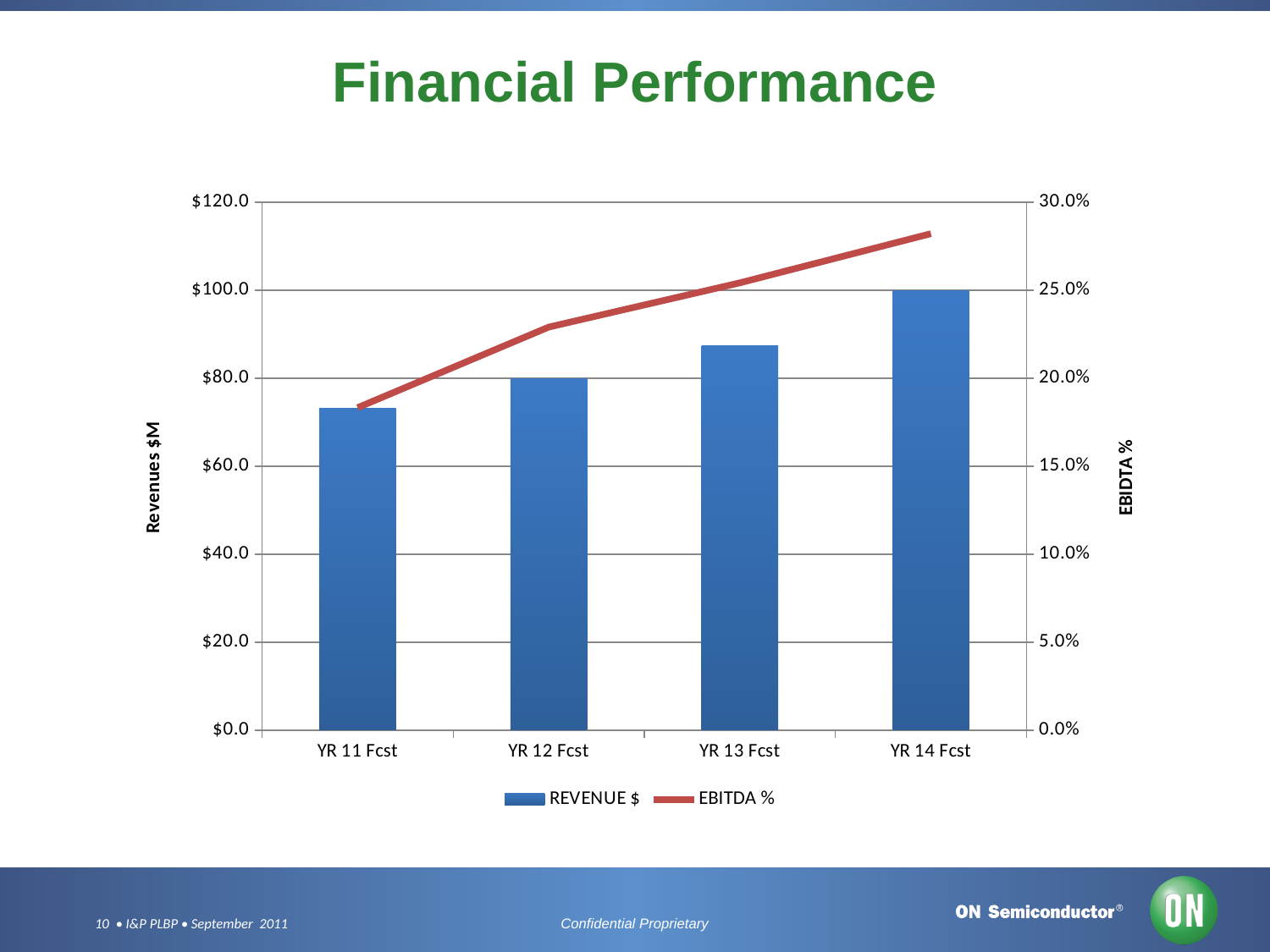
Which category has the highest revenue? YR 14 Fcst What is the difference in revenue between YR 14 Fcst and YR 12 Fcst? $20.0 How many categories are shown on the x axis? 4 Is the revenue for YR 11 Fcst greater or less than $80.0? less Is the EBITDA % for YR 14 Fcst greater or less than 25.0%? greater Does the EBITDA % line rise or fall from YR 11 Fcst to YR 14 Fcst? rise Which has higher revenue, YR 13 Fcst or YR 12 Fcst? YR 13 Fcst Is the EBITDA % for YR 11 Fcst greater or less than 20.0%? less How many series does the legend list? 2 What is the revenue value for YR 14 Fcst? $100.0 Which category has the lowest revenue? YR 11 Fcst What is the revenue value for YR 12 Fcst? $80.0